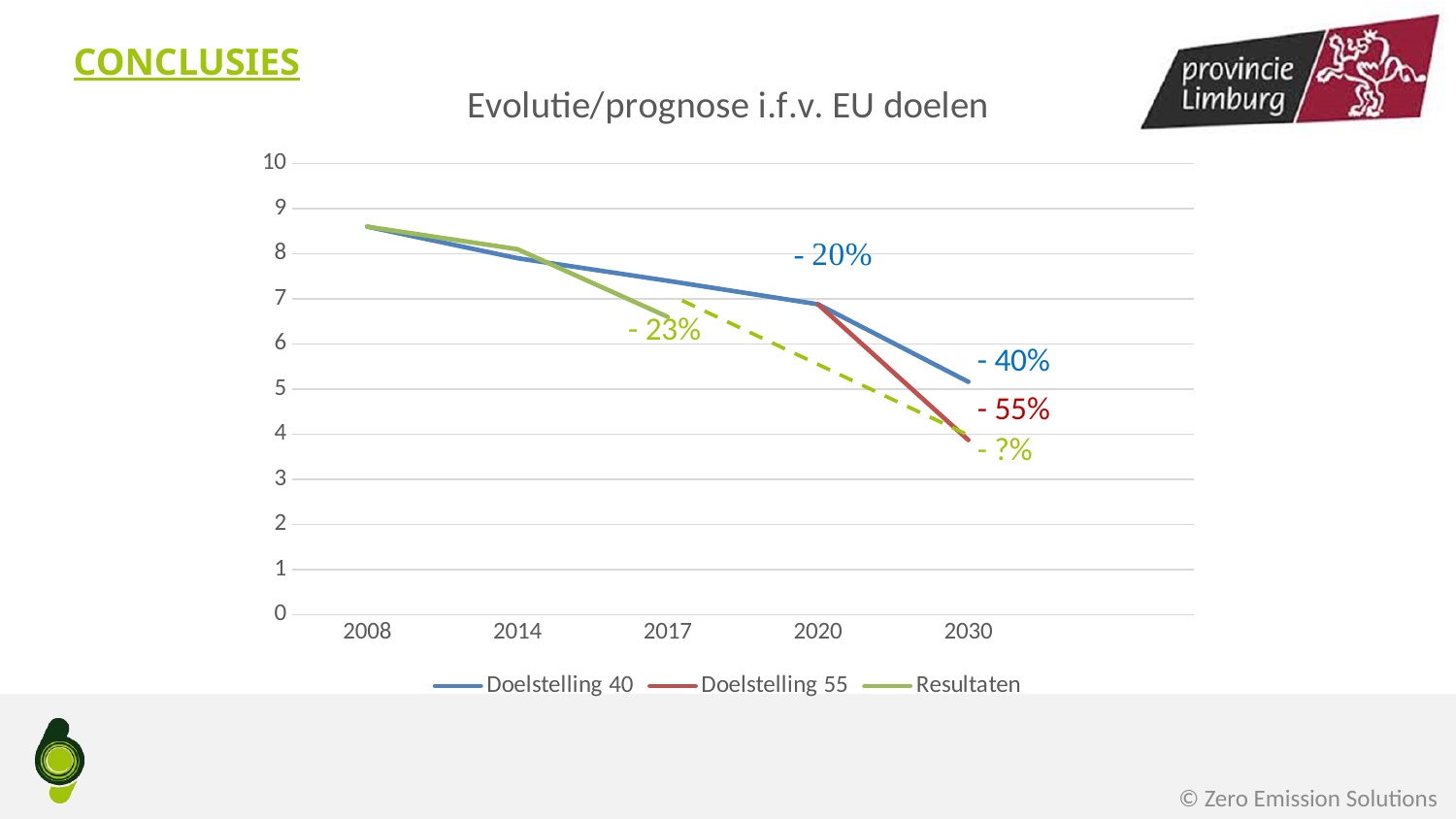
Is the value for Resultaten in 2017 greater or less than 7? less Is the value for Doelstelling 40 in 2030 greater or less than 6? less Do the values of the Doelstelling 40 series rise or fall from 2008 to 2030? fall What type of chart is shown on the slide? line chart Is the value for Doelstelling 40 in 2008 greater or less than 8? greater How many years are shown on the x axis? 5 What is the title of the chart? Evolutie/prognose i.f.v. EU doelen What percentage label is printed next to the Doelstelling 40 line at 2020? - 20% How many series does the legend list? 3 At 2030, which series has the higher value: Doelstelling 40 or Doelstelling 55? Doelstelling 40